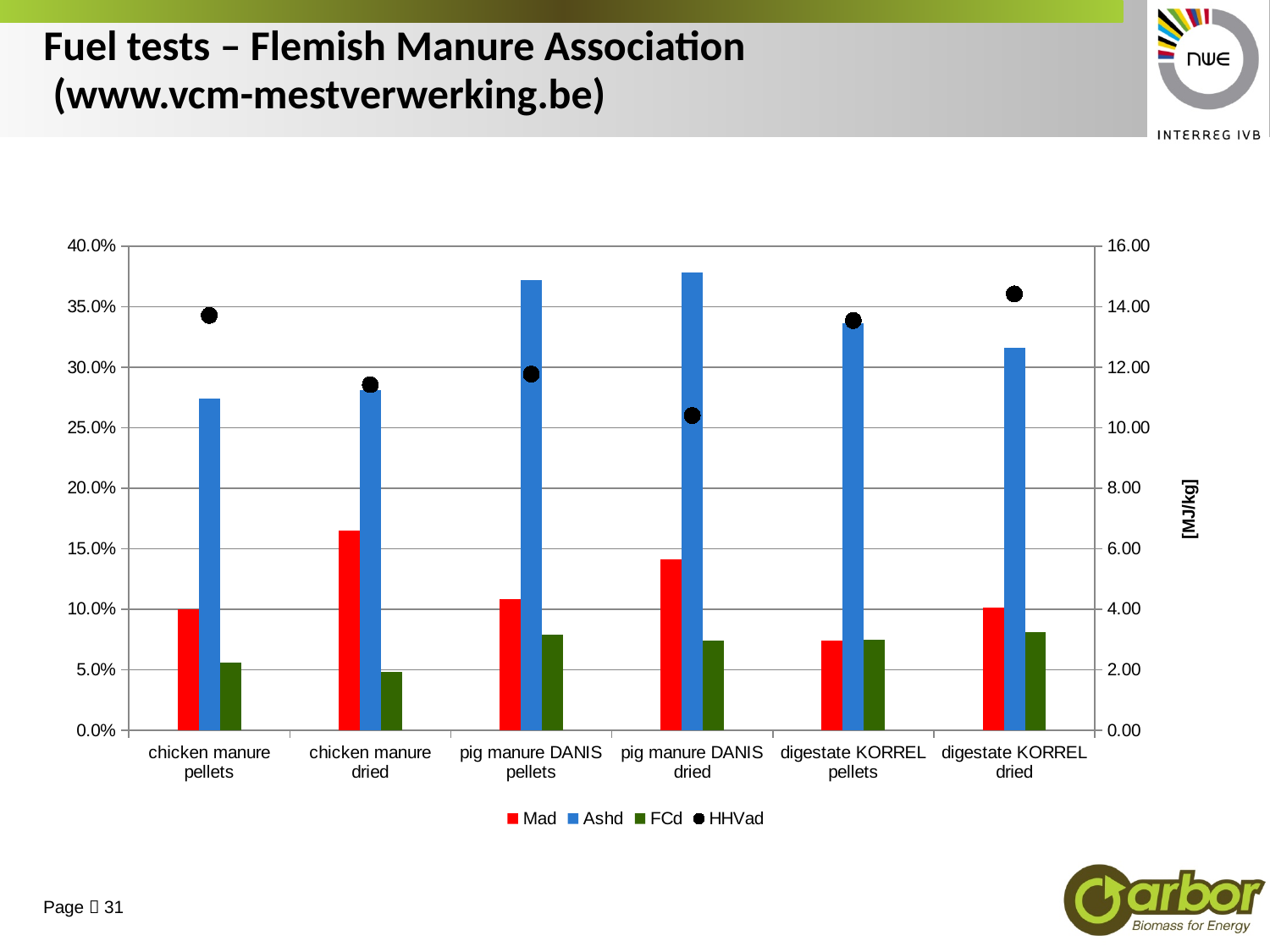
Which category has the lowest Mad value? digestate KORREL pellets What kind of chart is shown on the slide? bar chart How many categories are shown on the x axis of the chart? 6 Which category has the lowest HHVad value? pig manure DANIS dried Which category has the highest Mad value? chicken manure dried Is the HHVad value for chicken manure pellets greater or less than 12.00 MJ/kg? greater Is the Mad value for chicken manure dried greater or less than 15.0%? greater Which is larger, the Ashd value for digestate KORREL pellets or for digestate KORREL dried? digestate KORREL pellets What unit is shown on the right-hand vertical axis of the chart? [MJ/kg] Which category has the lowest FCd value? chicken manure dried How many series does the chart legend list? 4 Is the Ashd value for pig manure DANIS pellets greater or less than 35.0%? greater